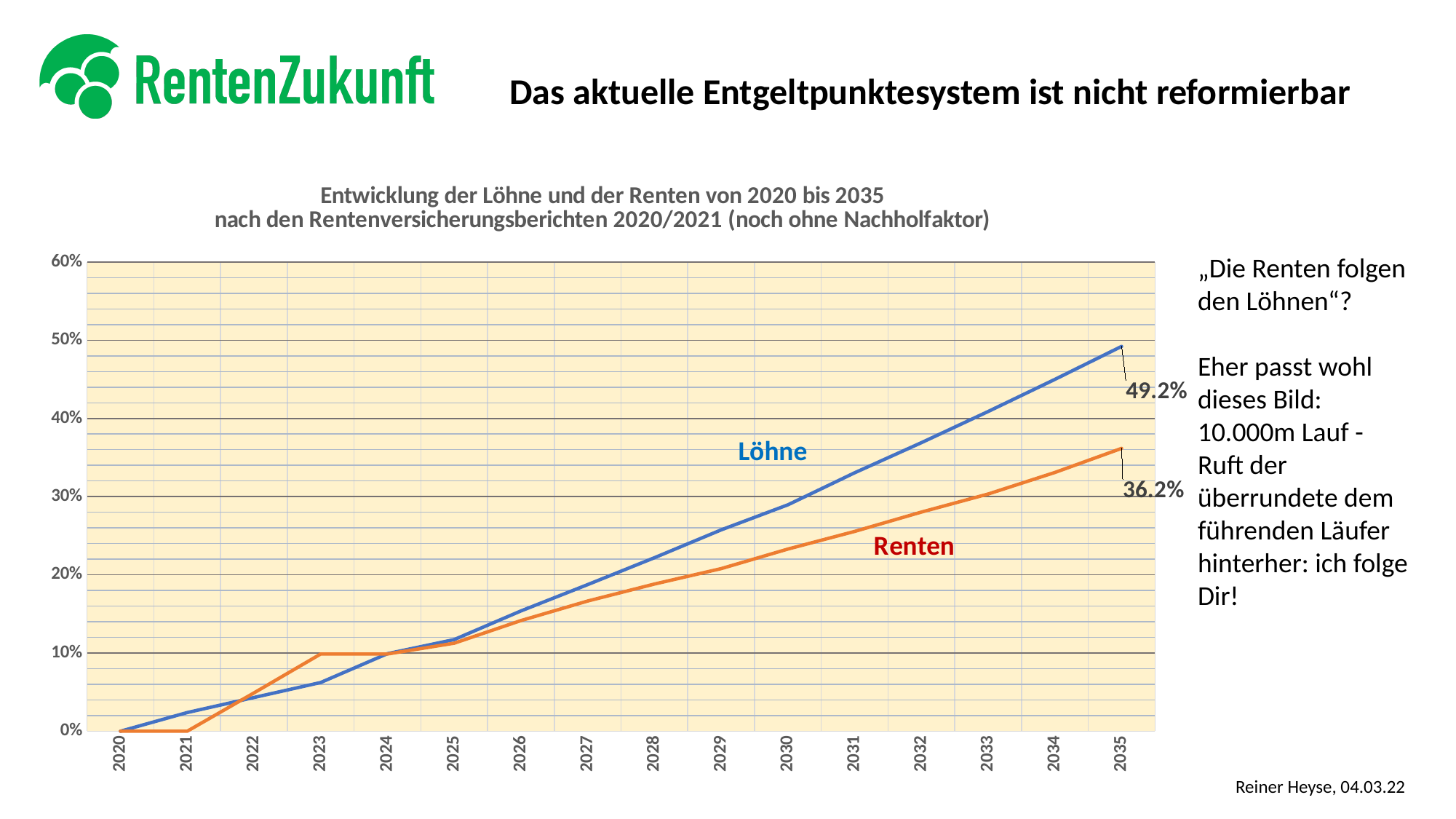
What is the value of Renten in 2021? 0% What kind of chart is shown on the slide? line chart How many years are shown on the x axis? 16 Is the value for Löhne in 2031 greater or less than 30%? greater Does the Löhne line rise or fall from 2020 to 2035? rise How many series are plotted in the chart? 2 What is the value of Löhne in 2035? 49.2% What colour is the Löhne line? blue Is the value for Renten in 2030 greater or less than 30%? less What is the difference between the Löhne and Renten values in 2035? 13.0% In 2035, which series has the higher value, Löhne or Renten? Löhne What is the value of Renten in 2035? 36.2%